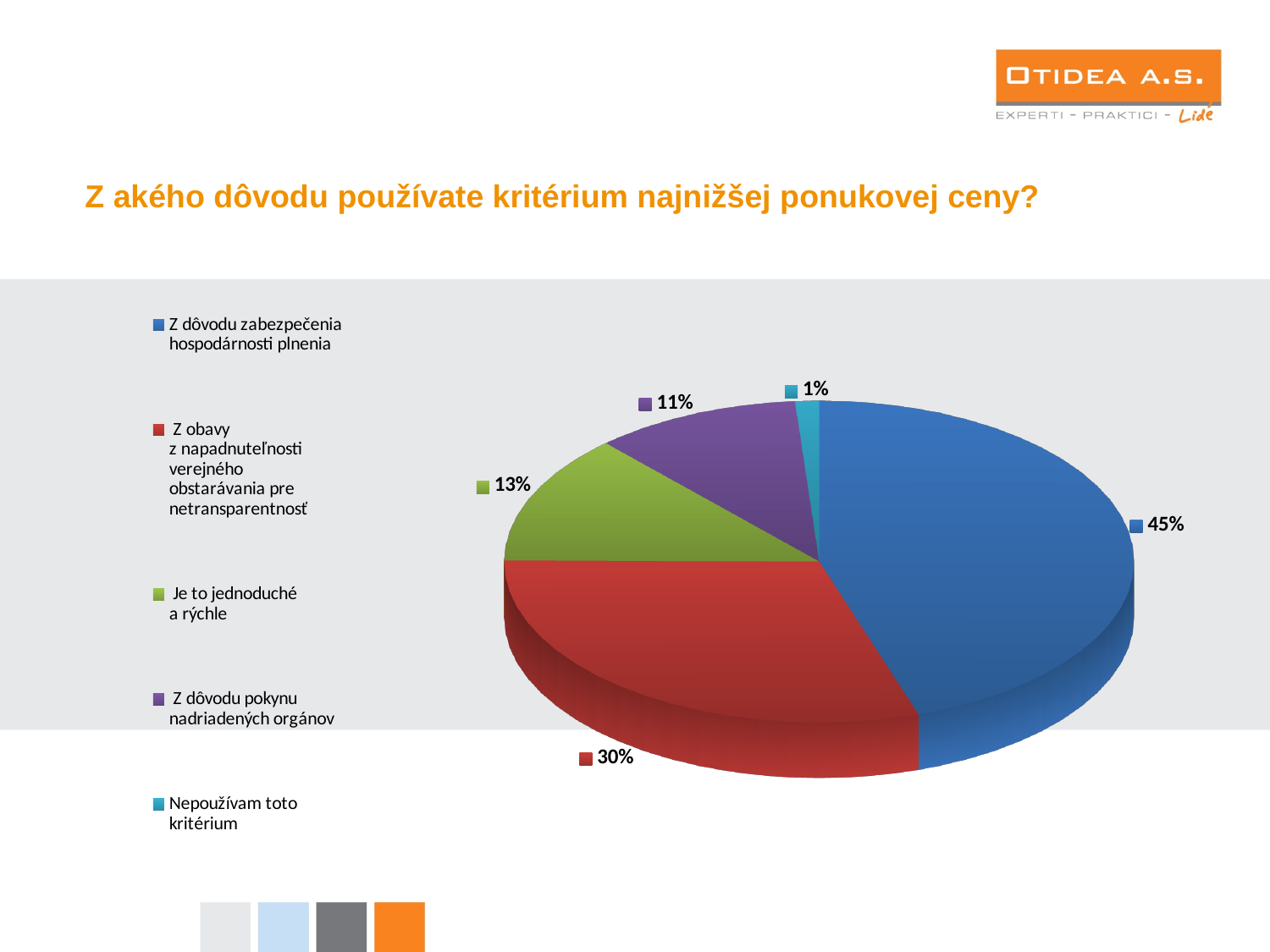
What share of the pie is 'Z obavy z napadnuteľnosti verejného obstarávania pre netransparentnosť'? 30% What share of the pie is 'Z dôvodu pokynu nadriadených orgánov'? 11% Which category has the largest share of the pie? Z dôvodu zabezpečenia hospodárnosti plnenia What share of the pie is 'Je to jednoduché a rýchle'? 13% Which category has the smallest share of the pie? Nepoužívam toto kritérium What share of the pie is 'Nepoužívam toto kritérium'? 1% What is the difference in percentage points between 'Z dôvodu zabezpečenia hospodárnosti plnenia' and 'Z obavy z napadnuteľnosti verejného obstarávania pre netransparentnosť'? 15% What colour is the slice for 'Z obavy z napadnuteľnosti verejného obstarávania pre netransparentnosť'? Red What kind of chart is shown on the slide? Pie chart How many categories does the pie chart have? 5 What share of the pie is 'Z dôvodu zabezpečenia hospodárnosti plnenia'? 45% Which is larger: the share for 'Je to jednoduché a rýchle' or the share for 'Z dôvodu pokynu nadriadených orgánov'? Je to jednoduché a rýchle